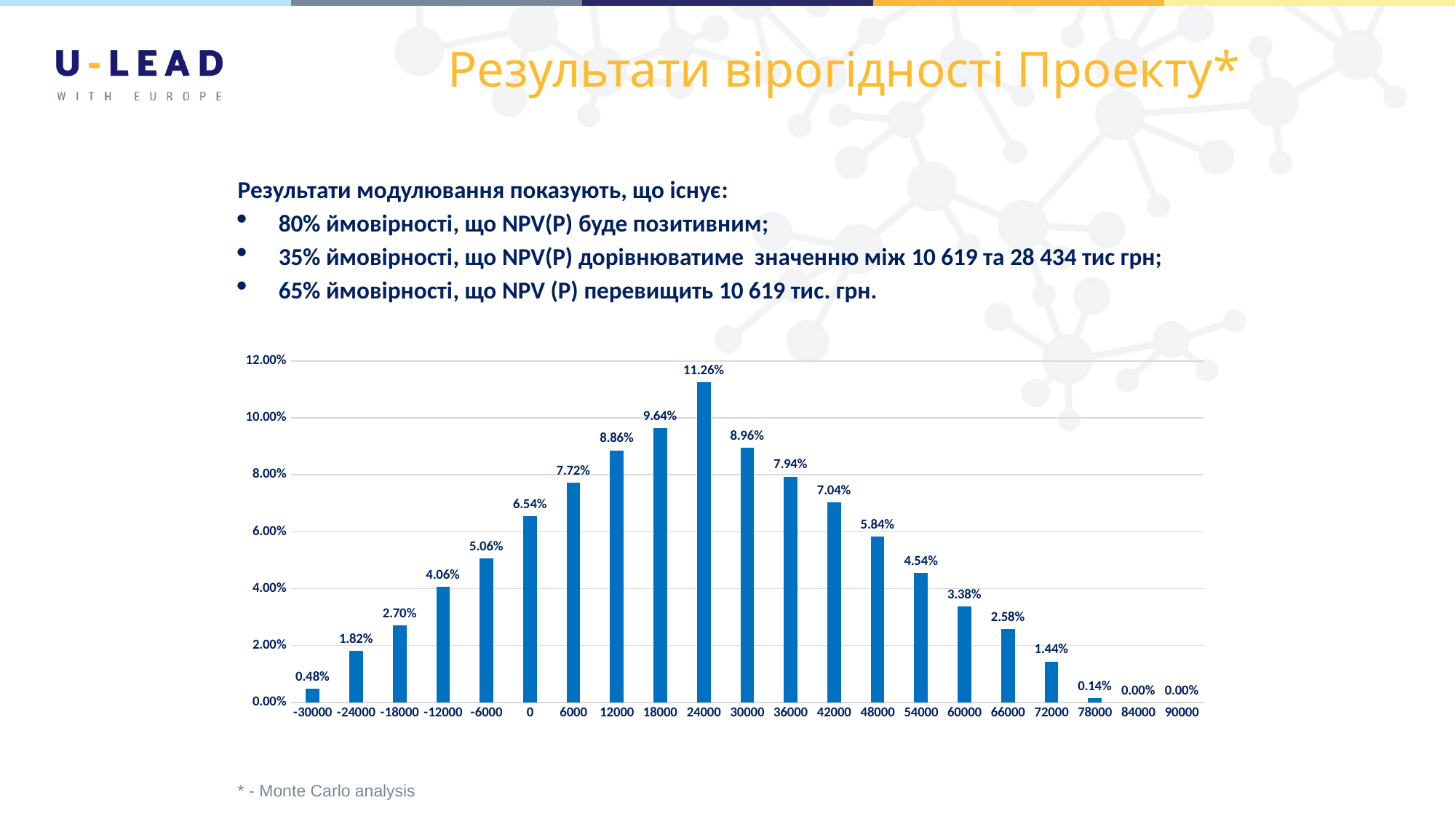
What is the difference between the values for 24000 and 18000? 1.62% Which category has the highest value? 24000 How many categories are shown on the x axis? 21 What is the value for the -12000 category? 4.06% Which is larger, the value for 0 or the value for 42000? 42000 Is the value for 54000 greater or less than 4.00%? greater What is the value for the 60000 category? 3.38% What is the value for the 24000 category? 11.26% Do the values rise or fall from -30000 to 24000 along the x axis? rise What is the title of the slide containing the chart? Результати вірогідності Проекту* What is the difference between the values for 30000 and 36000? 1.02% What kind of chart is shown on the slide? bar chart